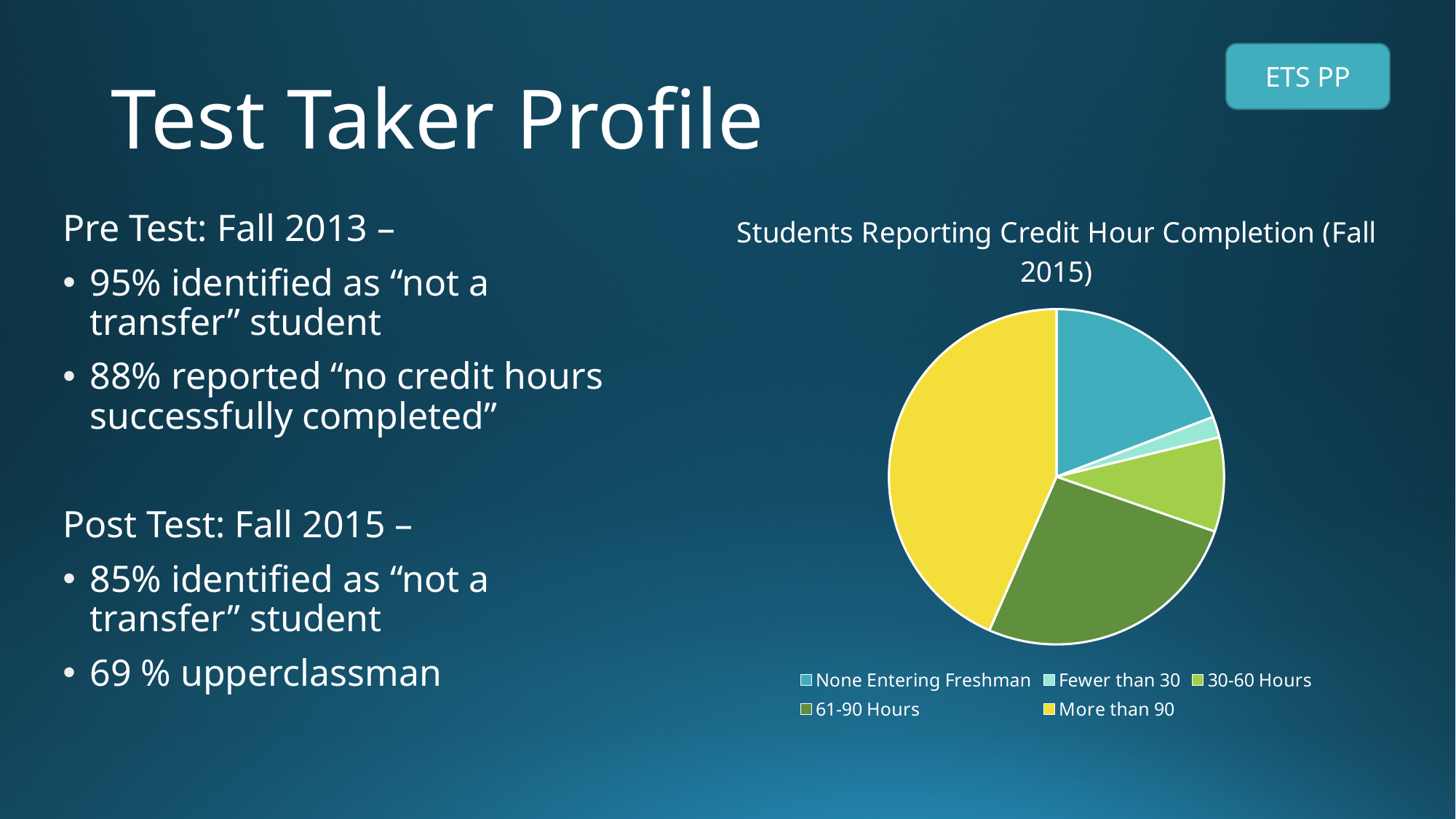
Which slice is larger: More than 90 or 61-90 Hours? More than 90 How many slices does the pie chart have? 5 Which slice is larger: 61-90 Hours or None Entering Freshman? 61-90 Hours Which slice is larger: 30-60 Hours or Fewer than 30? 30-60 Hours Which category has the smallest slice of the pie chart? Fewer than 30 Which category is shown in yellow on the pie chart? More than 90 What kind of chart is shown on the slide? Pie chart What is the title of the pie chart? Students Reporting Credit Hour Completion (Fall 2015) How many entries does the pie chart's legend list? 5 Which category has the largest slice of the pie chart? More than 90